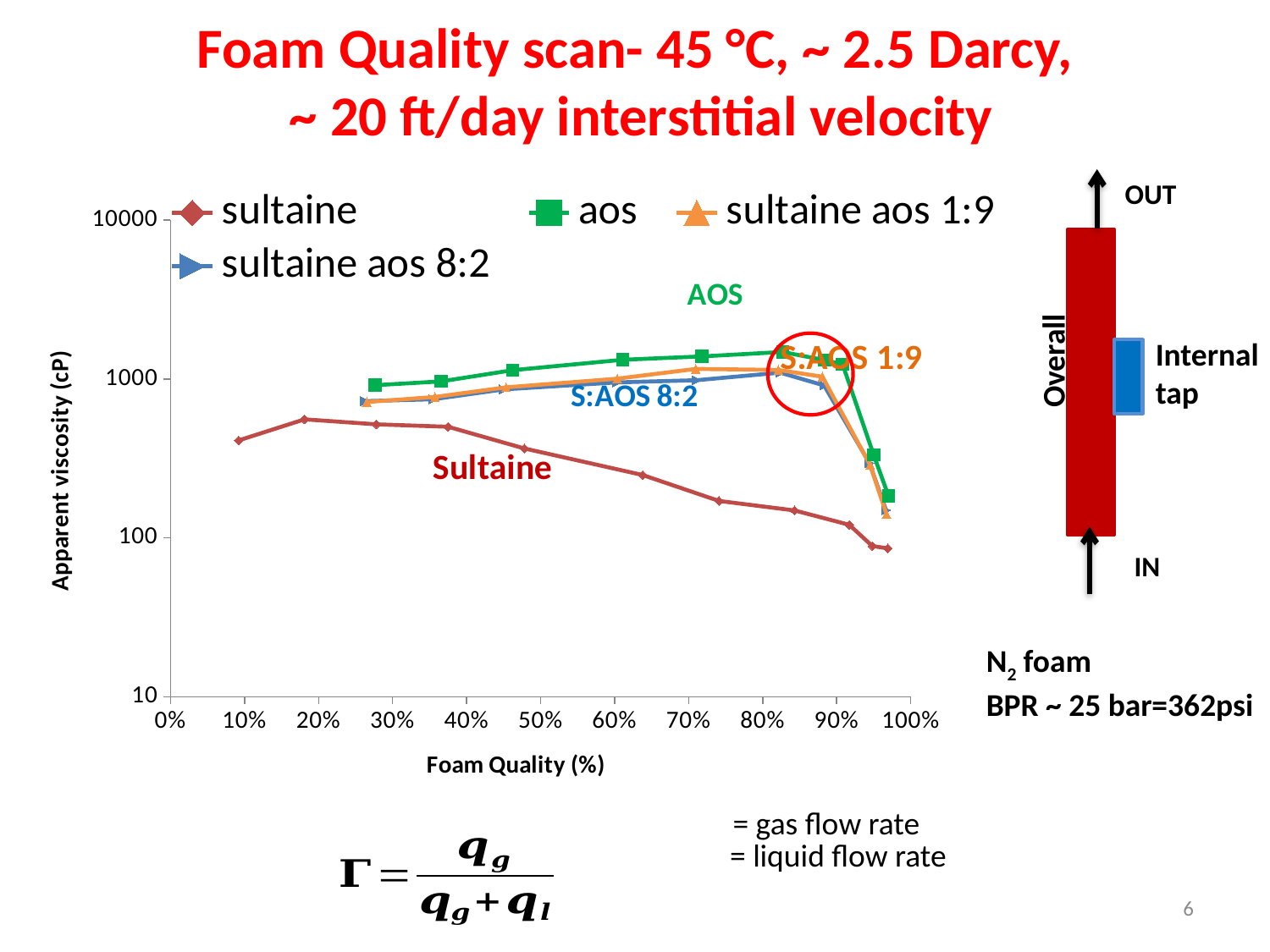
Does the apparent viscosity of the sultaine series rise or fall as foam quality increases from 20% to 97%? fall Does the apparent viscosity of the aos series rise or fall as foam quality increases from about 27% to about 82%? rise Is the apparent viscosity of the aos series at its last point near 97% foam quality greater or less than 100? greater Is the apparent viscosity of the aos series at about 70% foam quality greater or less than 1000? greater What kind of chart is shown on the slide? Line chart What is the label of the y axis of the chart? Apparent viscosity (cP) Is the apparent viscosity of the sultaine series at about 10% foam quality greater or less than 1000? less How many series does the chart legend list? 4 Which series has the lowest apparent viscosity across most of the foam quality range? sultaine What is the label of the x axis of the chart? Foam Quality (%) At about 70% foam quality, which series has the higher apparent viscosity, aos or sultaine? aos